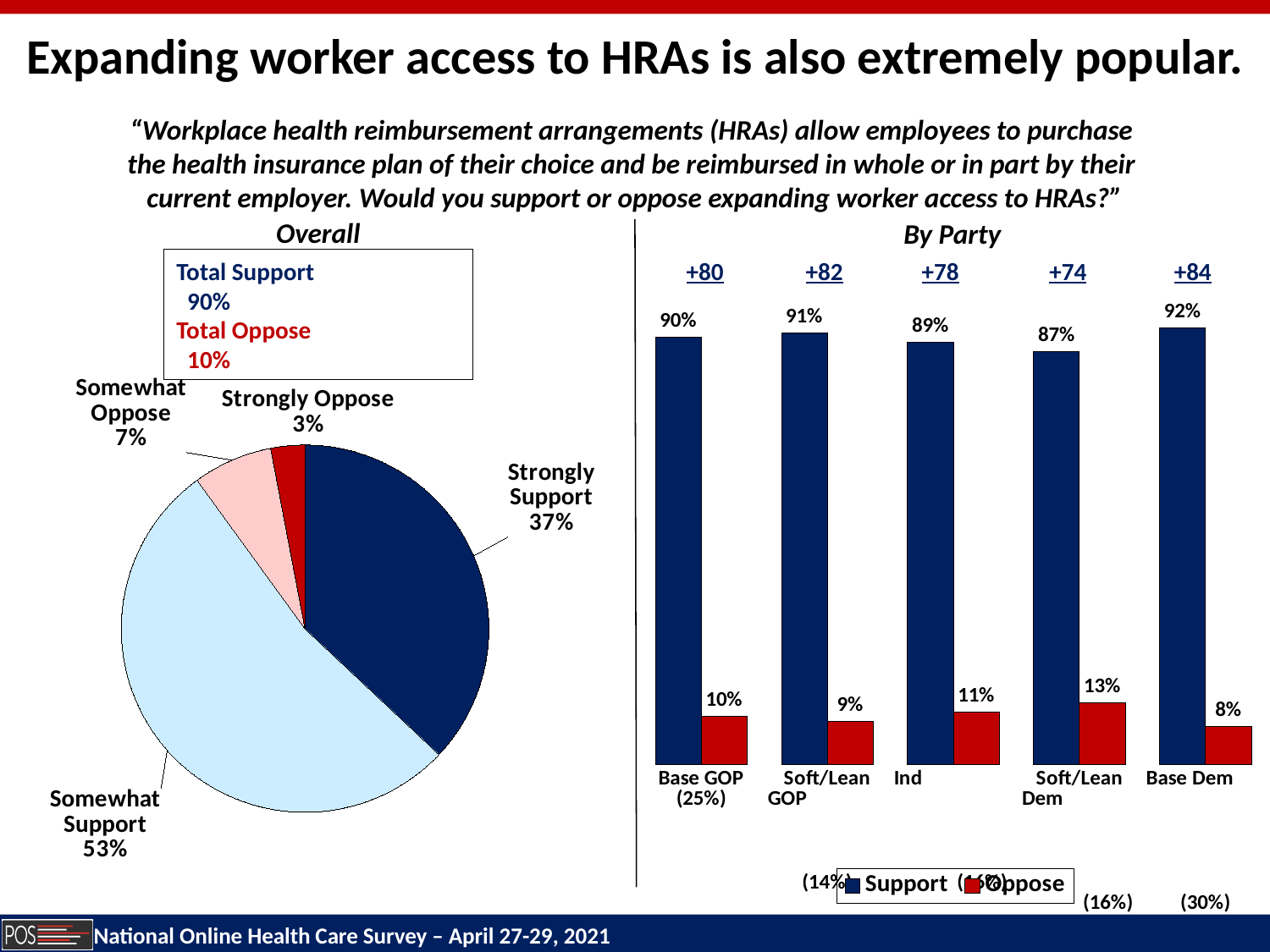
In the By Party chart, what is the Support value for Base Dem? 92% What kind of chart is the By Party chart? Bar chart In the Overall pie chart, which slice is the smallest? Strongly Oppose In the Overall pie chart, what share of respondents Strongly Oppose? 3% In the By Party chart, how many series does the legend list? 2 In the Overall pie chart, what is the difference between Strongly Support and Somewhat Oppose? 30% In the Overall pie chart, what share of respondents Somewhat Support? 53% In the By Party chart, which party group has the highest Support value? Base Dem In the By Party chart, what is the Oppose value for Soft/Lean Dem? 13% In the By Party chart, which party group has the lowest Oppose value? Base Dem In the Overall pie chart, how many slices are there? 4 In the Overall pie chart, which slice is the largest? Somewhat Support